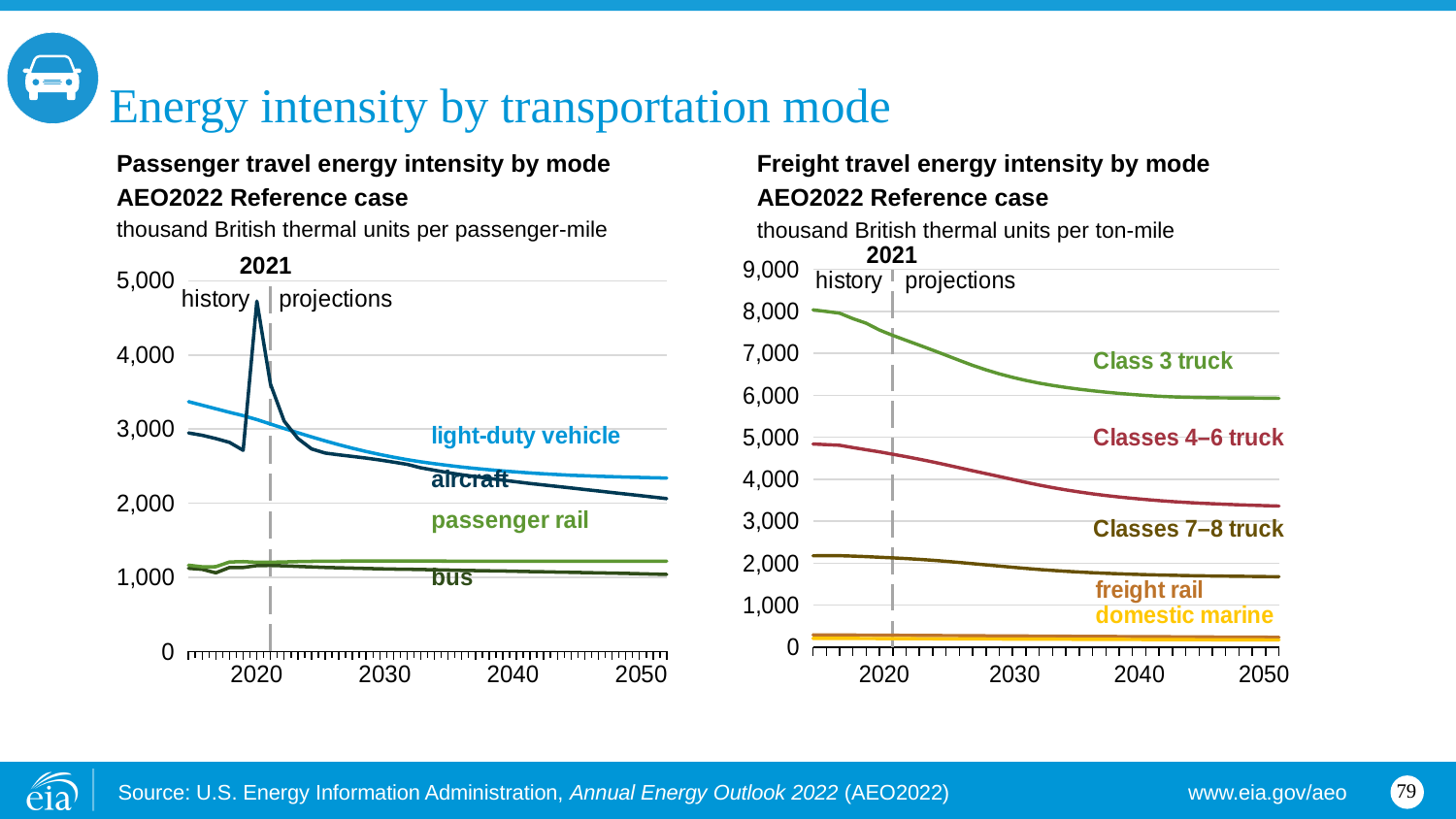
What year does the dashed vertical line separating history from projections mark on both charts? 2021 How many series are plotted on the 'Passenger travel energy intensity by mode' chart? 4 On the 'Freight travel energy intensity by mode' chart, does the Class 3 truck line rise or fall from 2020 to 2050? fall How many series are plotted on the 'Freight travel energy intensity by mode' chart? 5 On the 'Freight travel energy intensity by mode' chart, which mode has the highest energy intensity throughout the period? Class 3 truck On the 'Freight travel energy intensity by mode' chart, is the value for Classes 7–8 truck in 2050 greater or less than 2,000? less On the 'Passenger travel energy intensity by mode' chart, which is larger in 2050: light-duty vehicle or aircraft? light-duty vehicle On the 'Passenger travel energy intensity by mode' chart, is the peak value for aircraft greater or less than 4,000? greater On the 'Passenger travel energy intensity by mode' chart, is the value for light-duty vehicle in 2050 greater or less than 2,000? greater On the 'Passenger travel energy intensity by mode' chart, which mode has the highest energy intensity in 2050? light-duty vehicle What kind of chart is the 'Passenger travel energy intensity by mode' chart? line chart